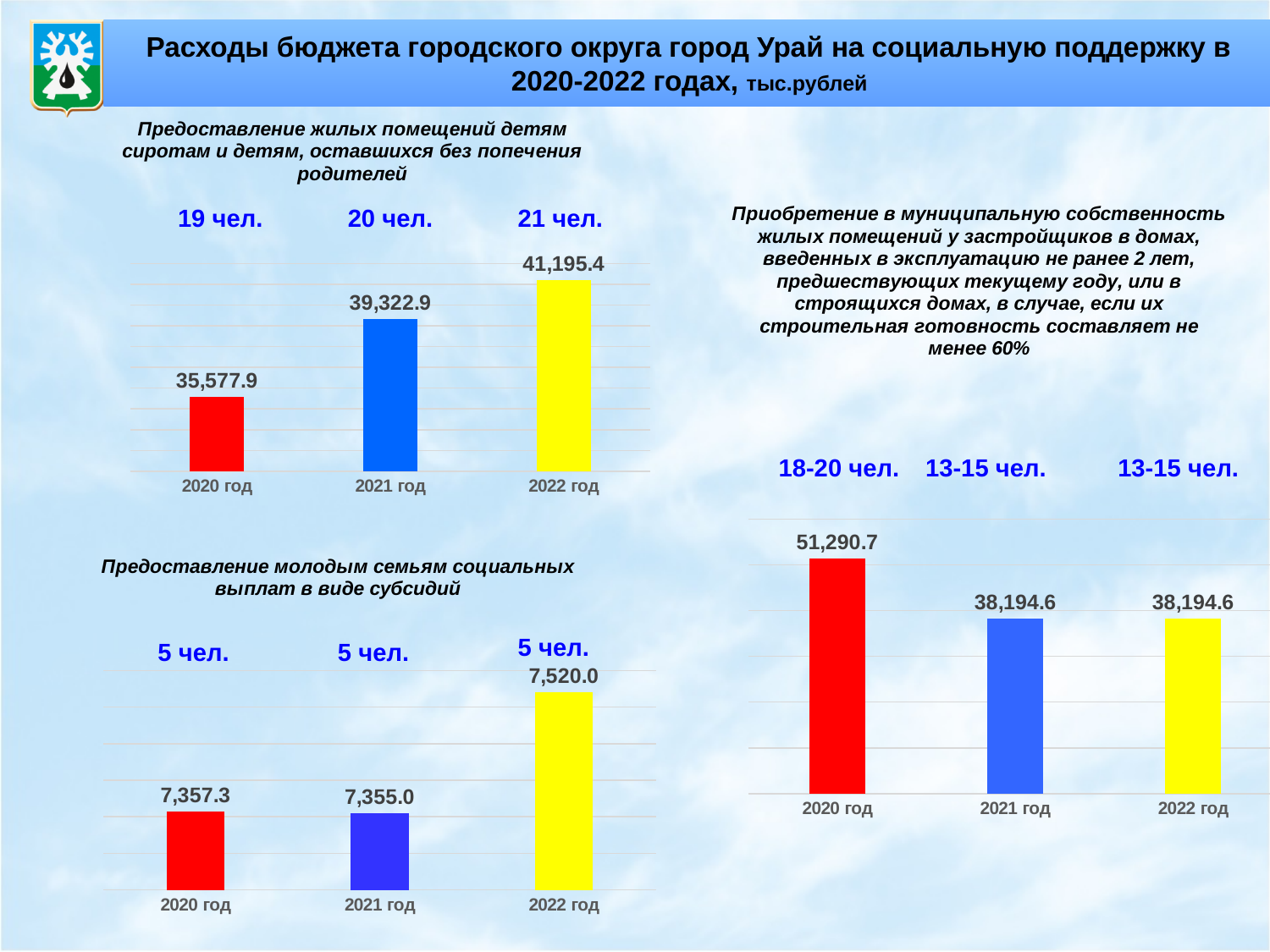
In the bottom-left chart (Предоставление молодым семьям социальных выплат), which year has the highest value? 2022 год In the bottom-left chart (Предоставление молодым семьям социальных выплат), what is the value for 2022 год? 7,520.0 How many bars does the right chart (Приобретение в муниципальную собственность жилых помещений) have? 3 In the top-left chart (Предоставление жилых помещений детям сиротам), do the values rise or fall from 2020 to 2022? rise In the top-left chart (Предоставление жилых помещений детям сиротам), which year has the highest value? 2022 год In the bottom-left chart (Предоставление молодым семьям социальных выплат), what is the difference between the 2022 and 2021 values? 165.0 What kind of chart is the top-left chart (Предоставление жилых помещений детям сиротам)? bar chart In the top-left chart (Предоставление жилых помещений детям сиротам), what is the difference between the 2022 and 2020 values? 5,617.5 In the top-left chart (Предоставление жилых помещений детям сиротам), what is the value for 2021 год? 39,322.9 In the right chart (Приобретение в муниципальную собственность жилых помещений), what is the difference between the 2020 and 2021 values? 13,096.1 In the right chart (Приобретение в муниципальную собственность жилых помещений), what is the value for 2020 год? 51,290.7 In the right chart (Приобретение в муниципальную собственность жилых помещений), which year has the highest value? 2020 год